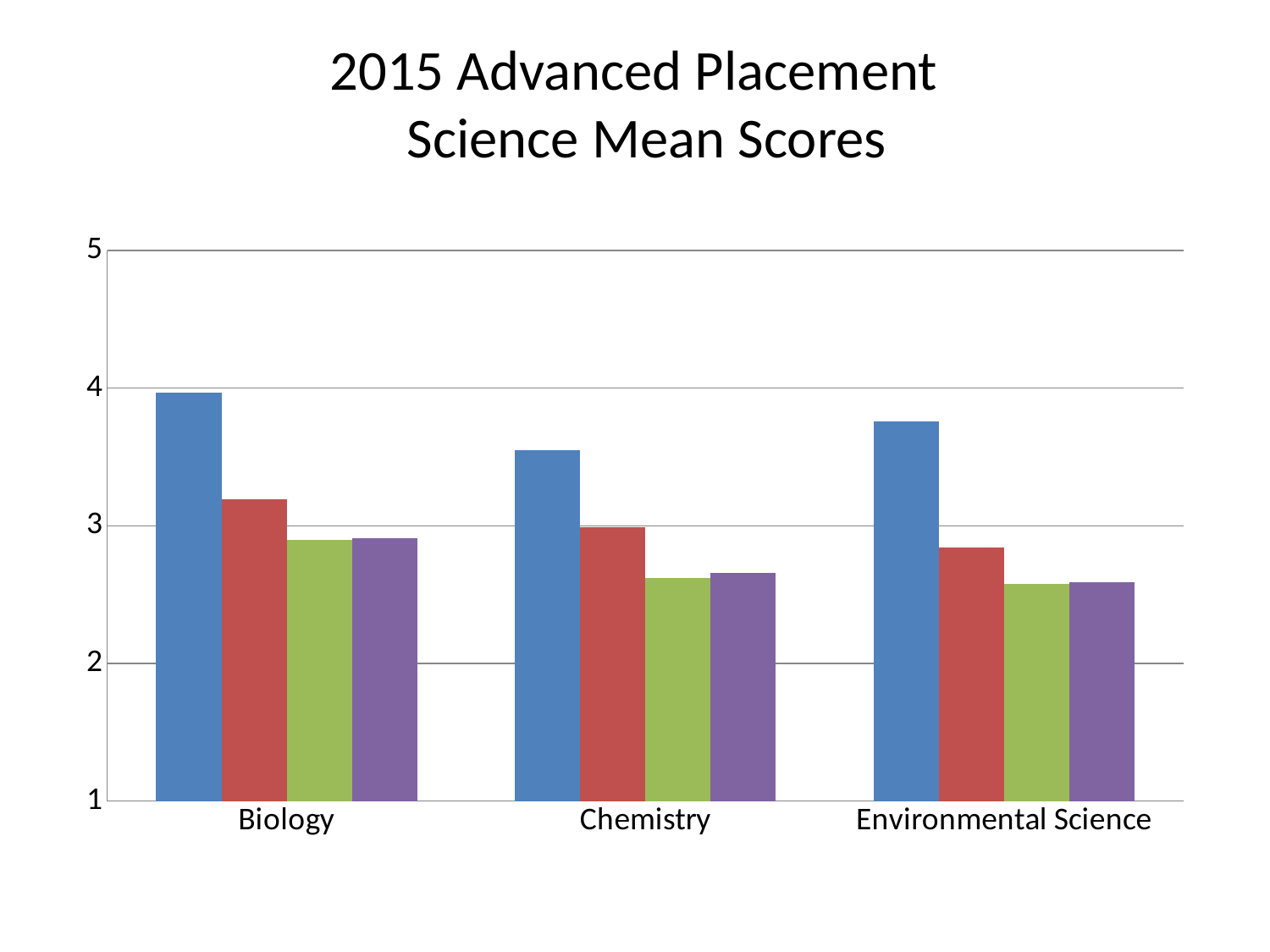
Which subject has the tallest blue bar? Biology Is the red bar for Biology greater or less than 3? greater Do the red bars rise or fall from Biology to Environmental Science along the x axis? fall What is the title of the chart? 2015 Advanced Placement Science Mean Scores How many bars are plotted for each subject category? 4 Which colour bar is the tallest in every subject category? blue What kind of chart is shown on the slide? bar chart Is the green bar for Environmental Science greater or less than 3? less How many subject categories are shown on the x axis? 3 Which subject has the shortest blue bar? Chemistry Which subject has the tallest red bar? Biology